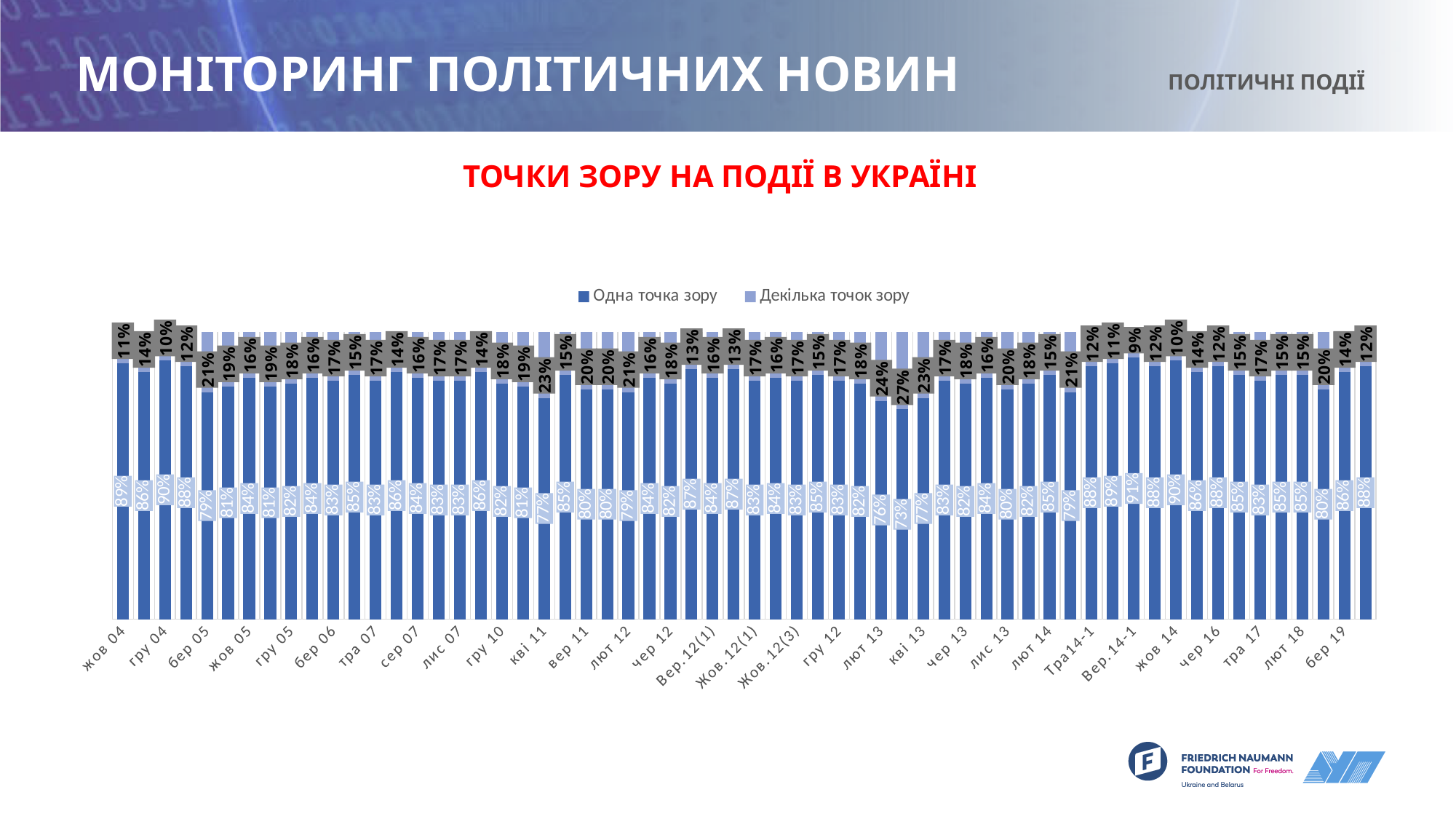
What is the title of the chart? ТОЧКИ ЗОРУ НА ПОДІЇ В УКРАЇНІ What is the lowest value shown for 'Декілька точок зору'? 9% How many series does the legend list? 2 What is the total of the stacked bar for жов 04? 100% What is the highest value shown for 'Декілька точок зору'? 27% What is the lowest value shown for 'Одна точка зору'? 73% What are the two series named in the legend? Одна точка зору; Декілька точок зору What kind of chart is shown on the slide? bar chart What is the value of 'Одна точка зору' for жов 04? 89% What is the value of 'Декілька точок зору' for жов 04? 11% For жов 04, which series has the larger value, 'Одна точка зору' or 'Декілька точок зору'? Одна точка зору What is the highest value shown for 'Одна точка зору'? 91%